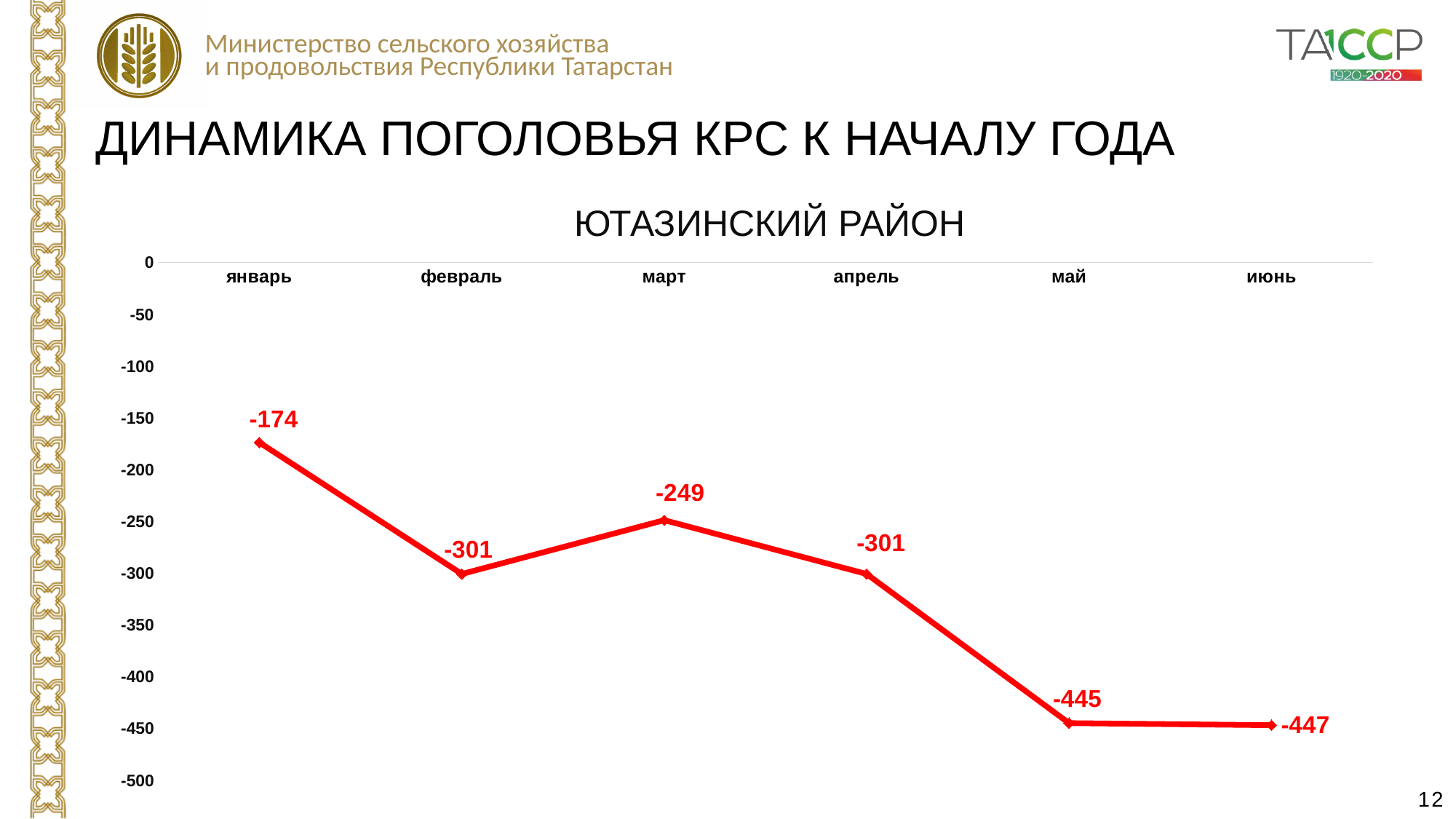
How many data points are plotted on the chart? 6 Which month has the highest value on the chart? январь What is the difference between the values for январь and июнь? 273 What is the title of the chart? ЮТАЗИНСКИЙ РАЙОН Which is larger, the value for февраль or the value for март? март What is the value for май on the chart? -445 What is the value for январь on the chart? -174 What is the difference between the values for апрель and май? 144 Which month has the lowest value on the chart? июнь What is the value for июнь on the chart? -447 What kind of chart is shown on the slide? line chart What is the value for март on the chart? -249